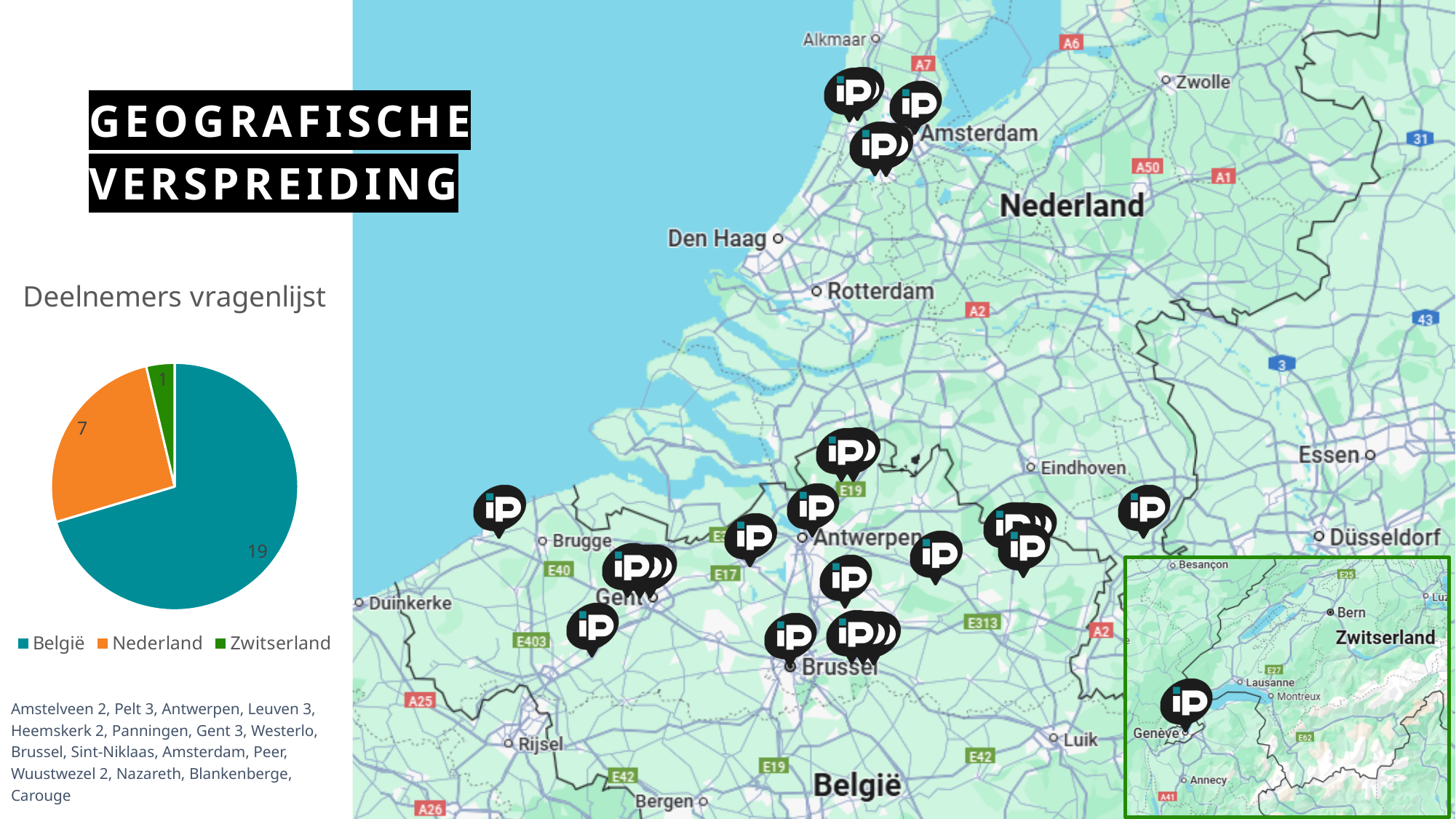
In the pie chart "Deelnemers vragenlijst", what is the value for Nederland? 7 What is the total of all slices in the pie chart "Deelnemers vragenlijst"? 27 In the pie chart "Deelnemers vragenlijst", what is the value for België? 19 In the pie chart "Deelnemers vragenlijst", what is the difference between the values for België and Nederland? 12 In the pie chart "Deelnemers vragenlijst", which is larger: the value for Nederland or the value for Zwitserland? Nederland Which country has the largest slice in the pie chart "Deelnemers vragenlijst"? België What kind of chart is shown under the title "Deelnemers vragenlijst"? pie chart Which country has the smallest slice in the pie chart "Deelnemers vragenlijst"? Zwitserland In the pie chart "Deelnemers vragenlijst", what is the value for Zwitserland? 1 How many categories does the pie chart "Deelnemers vragenlijst" show? 3 What colour is the Nederland slice in the pie chart "Deelnemers vragenlijst"? orange In the pie chart "Deelnemers vragenlijst", what fraction of the total does the België slice represent? 19/27